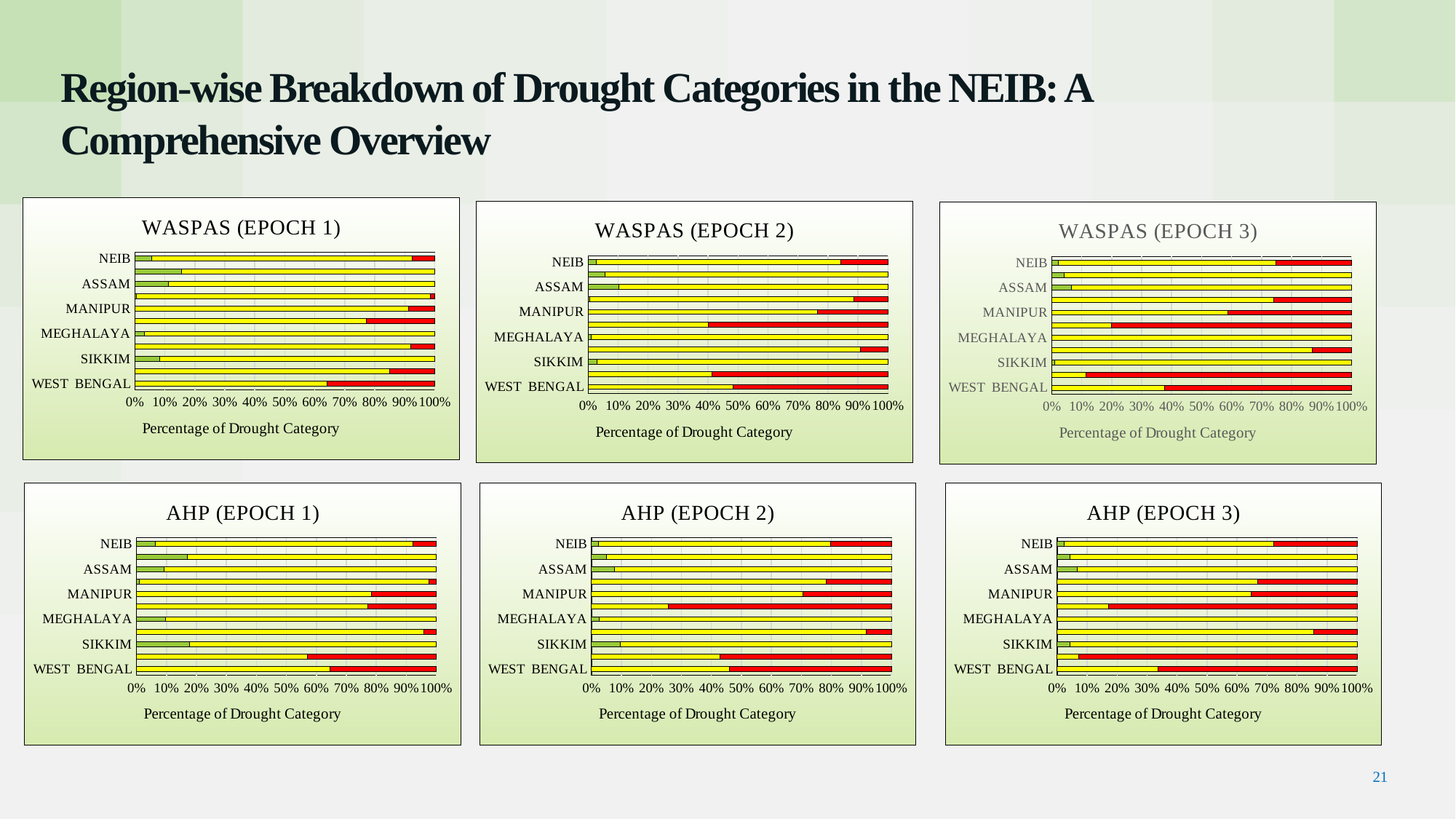
In AHP (EPOCH 3), which has the larger red segment, WEST BENGAL or MEGHALAYA? WEST BENGAL In WASPAS (EPOCH 3), which has the larger red segment, WEST BENGAL or NEIB? WEST BENGAL What kind of chart is WASPAS (EPOCH 1)? Stacked bar chart What is the x-axis title of the AHP (EPOCH 2) chart? Percentage of Drought Category In AHP (EPOCH 1), is the yellow segment for WEST BENGAL greater or less than 50%? greater In WASPAS (EPOCH 3), is the red segment for NEIB greater or less than 40%? less In WASPAS (EPOCH 1), is the yellow segment for WEST BENGAL greater or less than 50%? greater What is the maximum value shown on the x axis of the WASPAS (EPOCH 2) chart? 100% How many charts are shown on the slide? 6